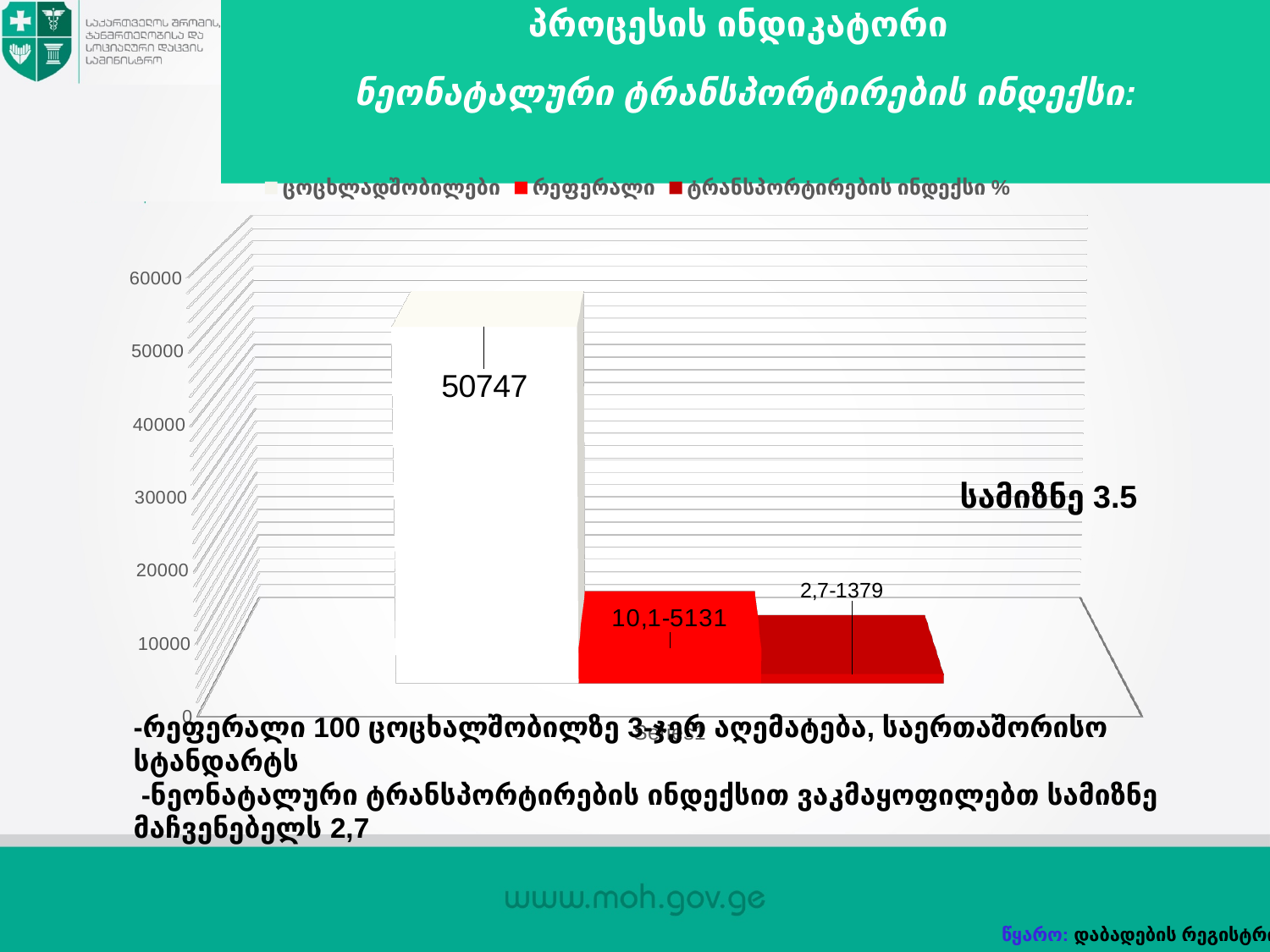
What is the highest value shown on the vertical axis? 60000 Which series has the shortest bar? ტრანსპორტირების ინდექსი % Which bar is taller, რეფერალი or ტრანსპორტირების ინდექსი %? რეფერალი What label is printed on the რეფერალი bar? 10,1-5131 Is the value for რეფერალი greater or less than 20000? less What value is labelled on the ცოცხალდშობილები bar? 50747 How many series does the legend list? 3 What label is printed on the ტრანსპორტირების ინდექსი % bar? 2,7-1379 Is the value for ცოცხალდშობილები greater or less than 40000? greater Which series has the tallest bar? ცოცხლადშობილები What kind of chart is shown on the slide? bar chart What colour is the რეფერალი bar? red